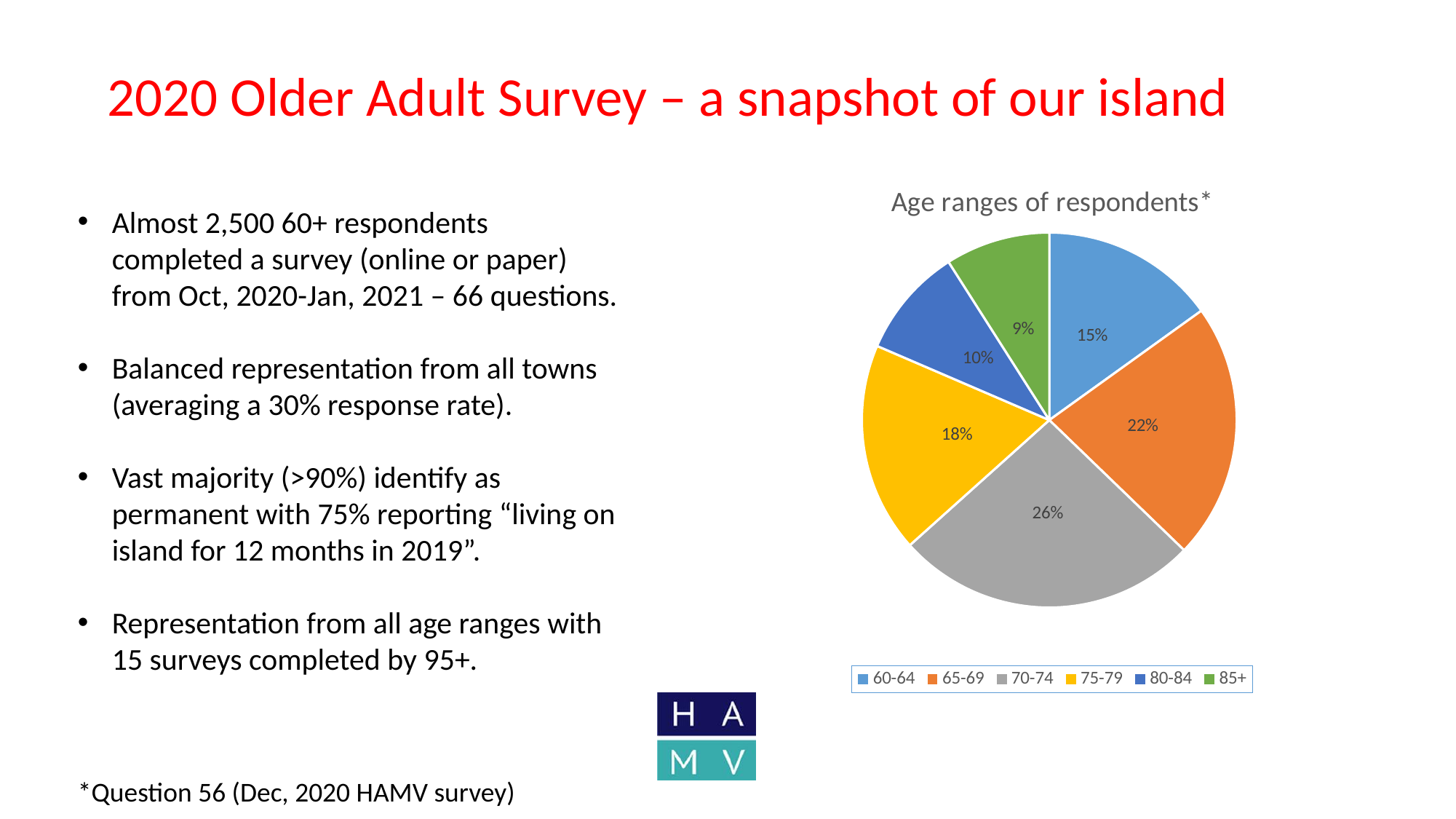
What is the title of the chart? Age ranges of respondents* Which age range has the smallest share of respondents? 85+ What kind of chart is shown on the slide? pie chart Which has a larger share of respondents, 65-69 or 75-79? 65-69 What is the difference in percentage points between the 65-69 and 80-84 age ranges? 12 What share of respondents are aged 85+? 9% How many age ranges does the legend list? 6 Which age range has the largest share of respondents? 70-74 What share of respondents are in the 60-64 age range? 15% What share of respondents are in the 70-74 age range? 26% What share of respondents are in the 75-79 age range? 18% What colour is the slice for the 75-79 age range? yellow